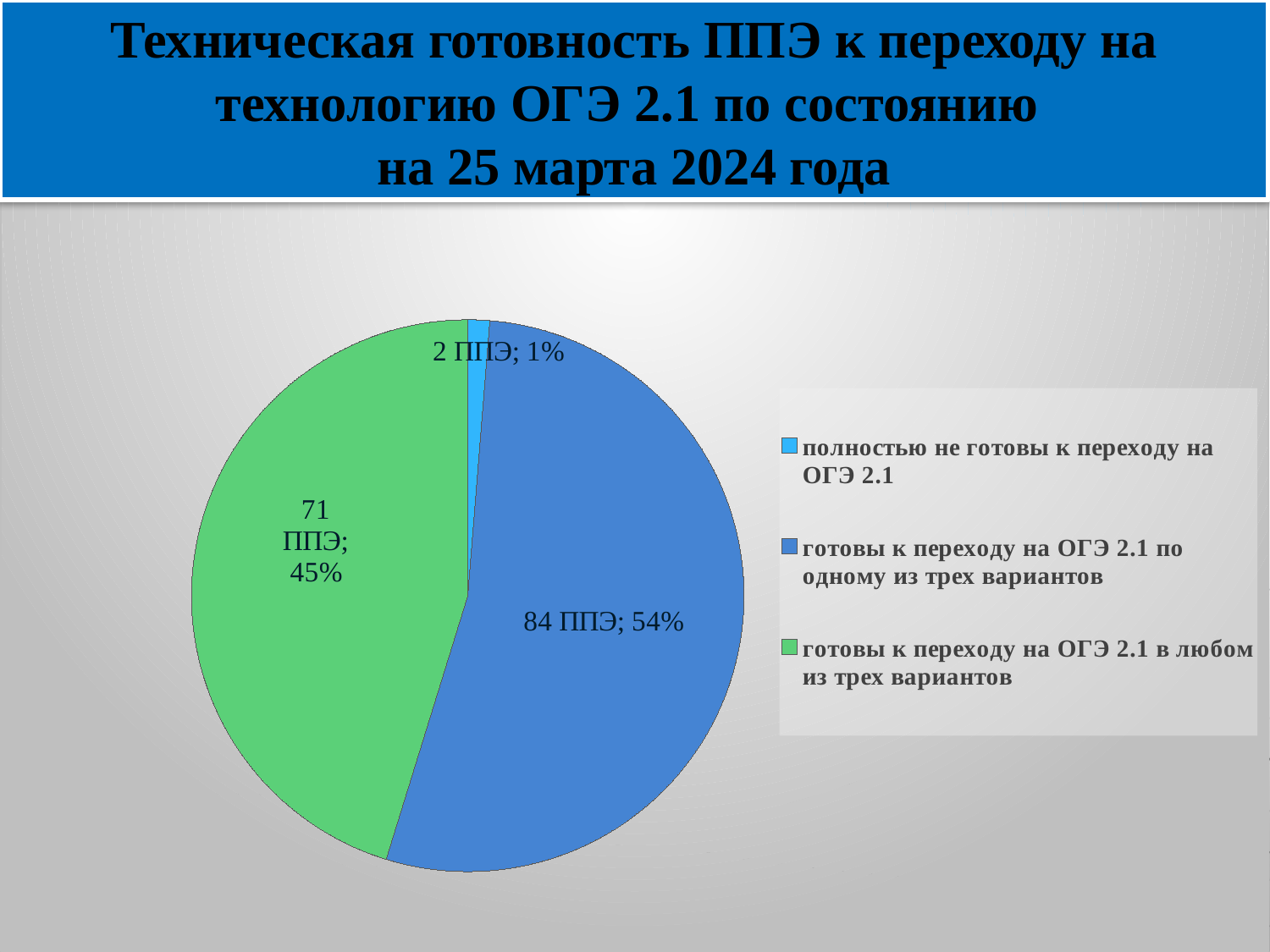
Какая категория имеет наибольшее число ППЭ? готовы к переходу на ОГЭ 2.1 по одному из трех вариантов Сколько ППЭ полностью не готовы к переходу на ОГЭ 2.1? 2 ППЭ Что больше: число ППЭ, готовых в любом из трех вариантов, или число ППЭ, полностью не готовых к переходу? готовы к переходу на ОГЭ 2.1 в любом из трех вариантов На сколько ППЭ больше готовы по одному из трех вариантов, чем в любом из трех вариантов? 13 Какую долю диаграммы занимают ППЭ, полностью не готовые к переходу на ОГЭ 2.1? 1% Какая категория имеет наименьшее число ППЭ? полностью не готовы к переходу на ОГЭ 2.1 Какую долю диаграммы занимают ППЭ, готовые к переходу на ОГЭ 2.1 по одному из трех вариантов? 54% Каким цветом на диаграмме обозначены ППЭ, готовые к переходу на ОГЭ 2.1 в любом из трех вариантов? зелёным Сколько ППЭ готовы к переходу на ОГЭ 2.1 в любом из трех вариантов? 71 ППЭ Сколько ППЭ готовы к переходу на ОГЭ 2.1 по одному из трех вариантов? 84 ППЭ Сколько категорий показано на круговой диаграмме? 3 Какой тип диаграммы показан на слайде? круговая диаграмма